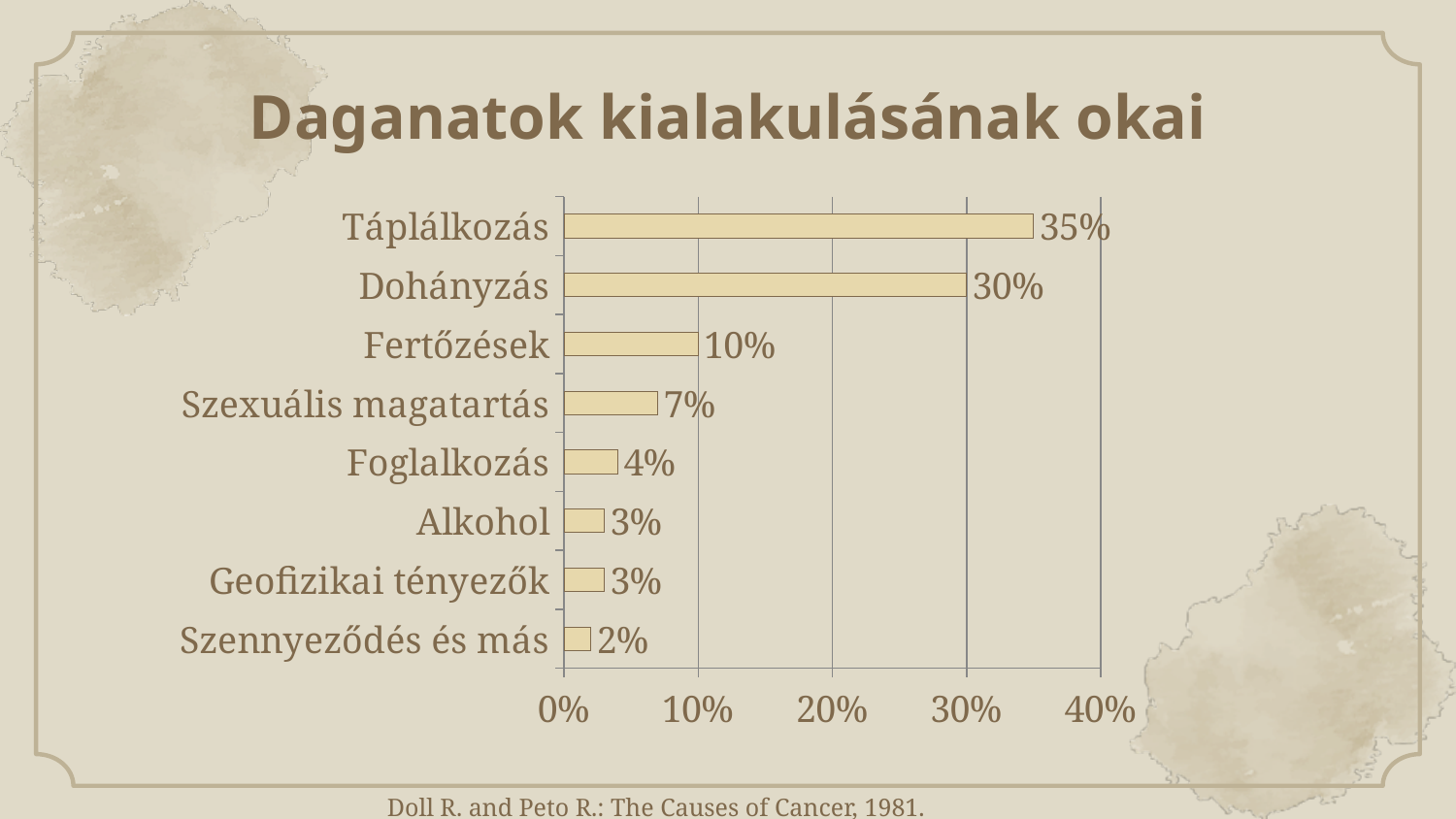
Which category has the highest value? Táplálkozás Which category has the lowest value? Szennyeződés és más What is the value for Dohányzás? 30% What is the difference between the values for Táplálkozás and Dohányzás? 5% What kind of chart is shown on the slide? Bar chart What is the highest value shown on the x axis? 40% What is the value for Táplálkozás? 35% How many categories are shown in the chart? 8 What is the title of the slide? Daganatok kialakulásának okai What is the value for Szexuális magatartás? 7% What is the value for Fertőzések? 10% Which is larger, the value for Foglalkozás or the value for Alkohol? Foglalkozás